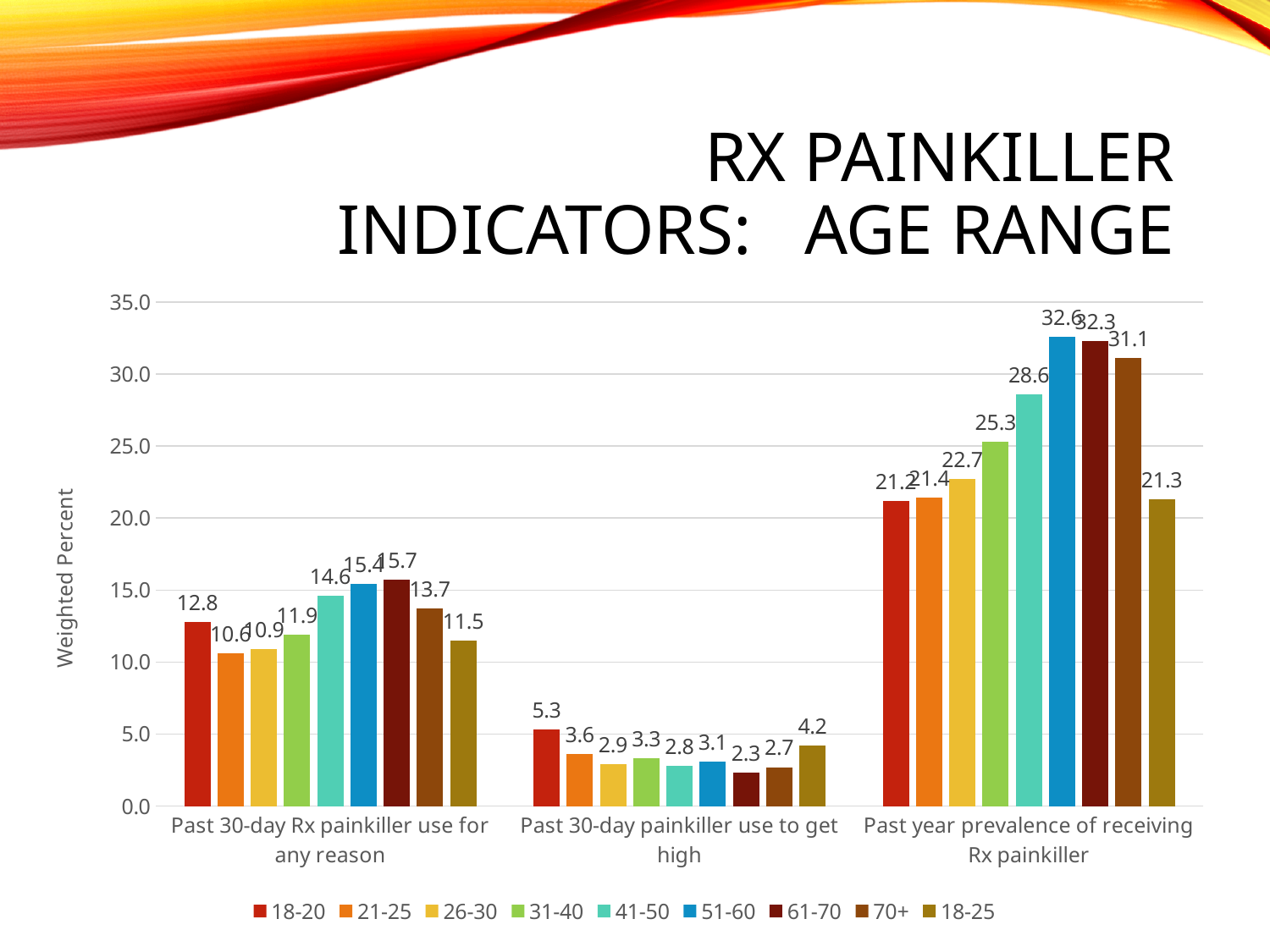
In the "Past 30-day painkiller use to get high" category, which age group has the lowest value? 61-70 How many categories are shown on the x axis of the chart? 3 What is the value for the 70+ age group in the "Past 30-day Rx painkiller use for any reason" category? 13.7 In the "Past year prevalence of receiving Rx painkiller" category, which is larger: the 31-40 value or the 26-30 value? 31-40 What is the value for the 18-20 age group in the "Past 30-day painkiller use to get high" category? 5.3 What kind of chart is shown on the slide? bar chart In the "Past 30-day painkiller use to get high" category, what is the difference between the 18-25 value and the 70+ value? 1.5 In the "Past 30-day Rx painkiller use for any reason" category, what is the difference between the 41-50 value and the 31-40 value? 2.7 What is the value for the 41-50 age group in the "Past year prevalence of receiving Rx painkiller" category? 28.6 In the "Past 30-day painkiller use to get high" category, which age group has the highest value? 18-20 Is the value for the 51-60 age group in the "Past year prevalence of receiving Rx painkiller" category greater or less than 30.0? greater How many age-group series does the legend list? 9